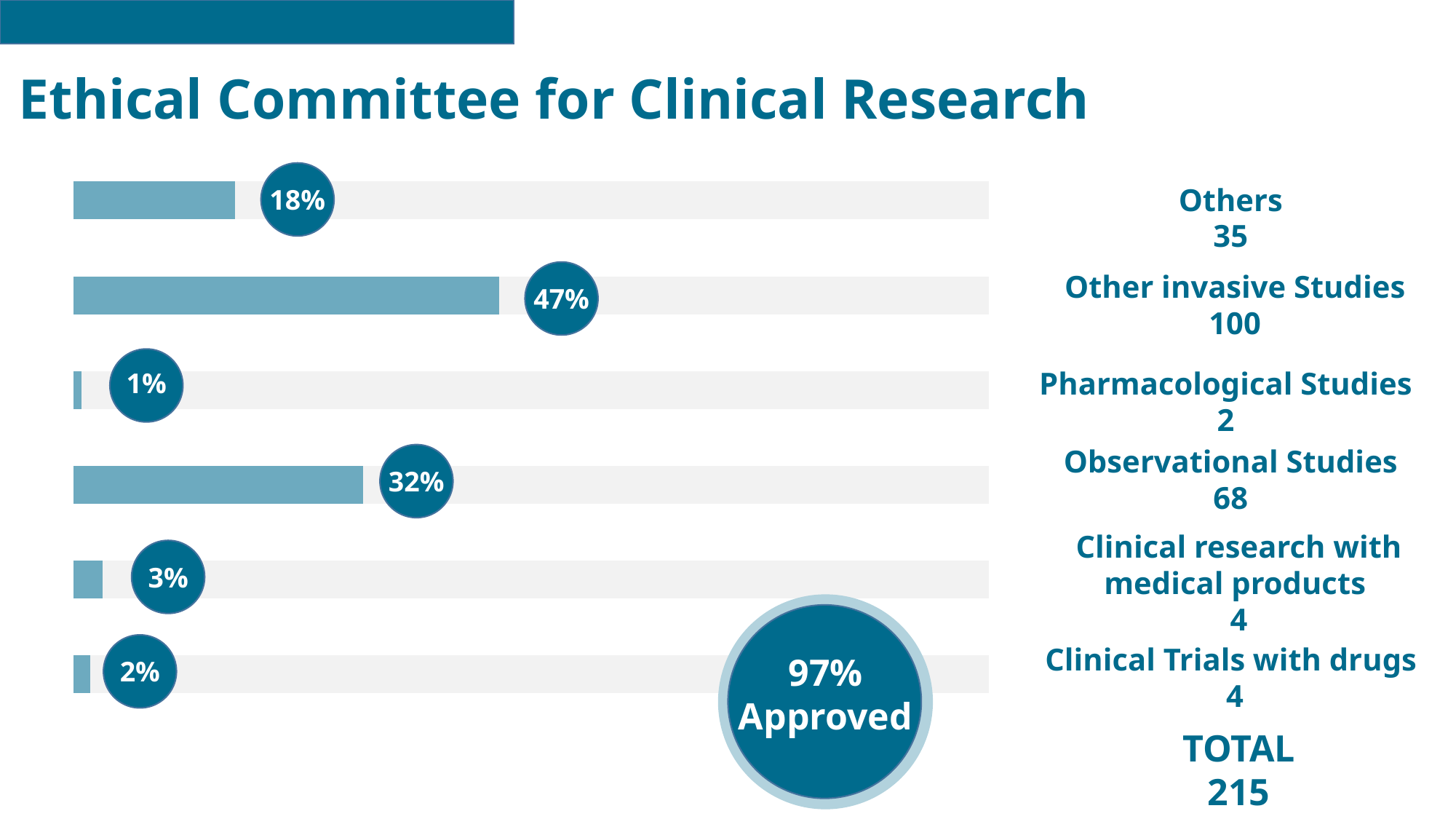
How many categories are shown in the bar chart? 6 What percentage is shown for Observational Studies? 32% What is the total number of studies shown on the slide? 215 What percentage is shown for Other invasive Studies? 47% Which is larger, the percentage for Others or for Observational Studies? Observational Studies What percentage is shown for Others? 18% How many studies are listed for Other invasive Studies? 100 What type of chart is shown on the slide? bar chart Which category has the lowest percentage? Pharmacological Studies What percentage is shown for Pharmacological Studies? 1% What is the difference in percentage points between Other invasive Studies and Observational Studies? 15 Which category has the highest percentage? Other invasive Studies